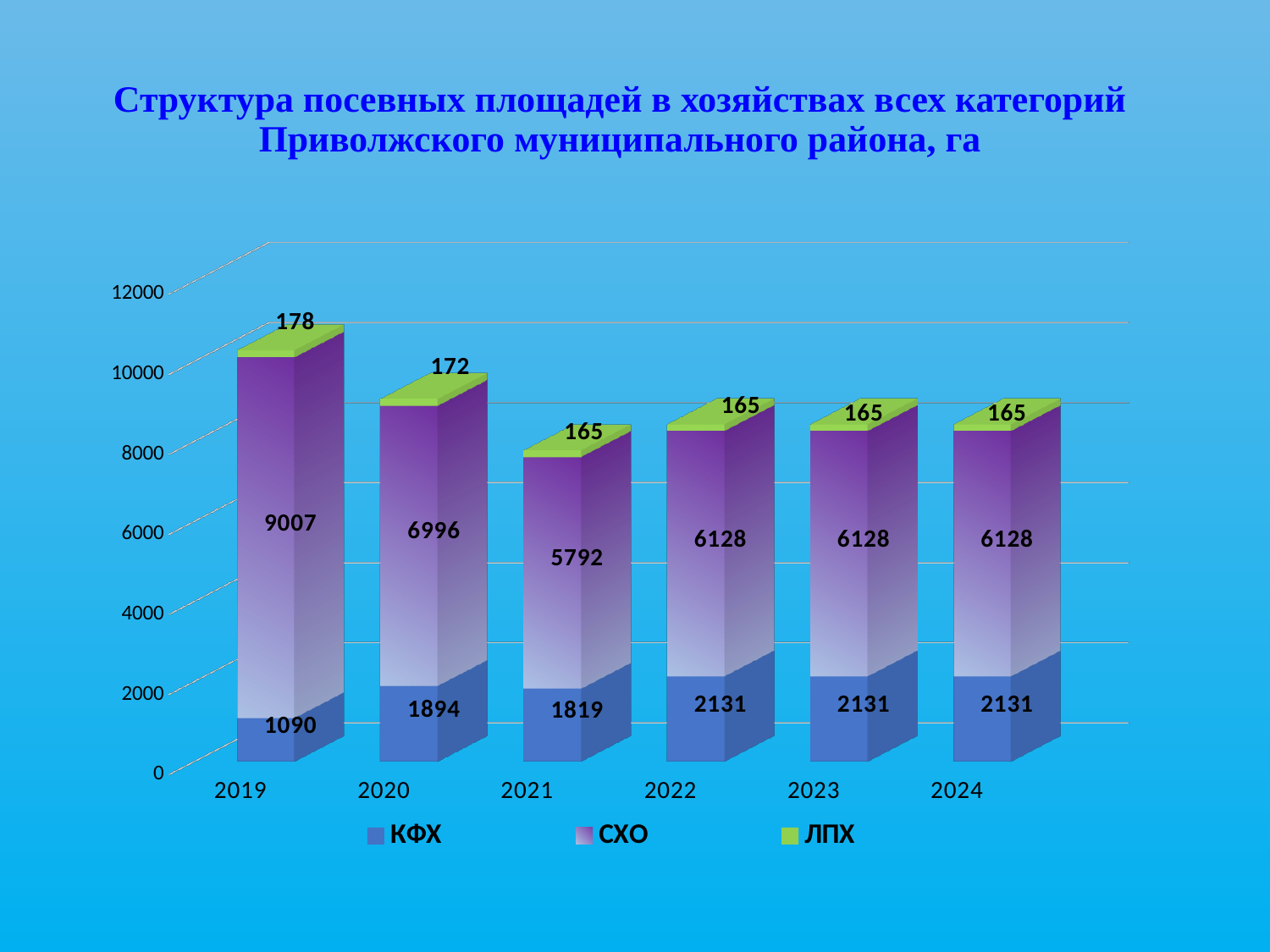
What is the value of СХО for 2019? 9007 What is the difference between the СХО values for 2019 and 2020? 2011 How many years are shown on the x axis? 6 What is the value of ЛПХ for 2020? 172 Which is larger, the КФХ value for 2020 or for 2021? 2020 How many series does the legend list? 3 What is the total of the stacked bar for 2022? 8424 What is the total of the stacked bar for 2019? 10275 What kind of chart is shown on the slide? stacked bar chart In which year is the КФХ value lowest? 2019 In which year is the СХО value highest? 2019 What is the value of КФХ for 2021? 1819